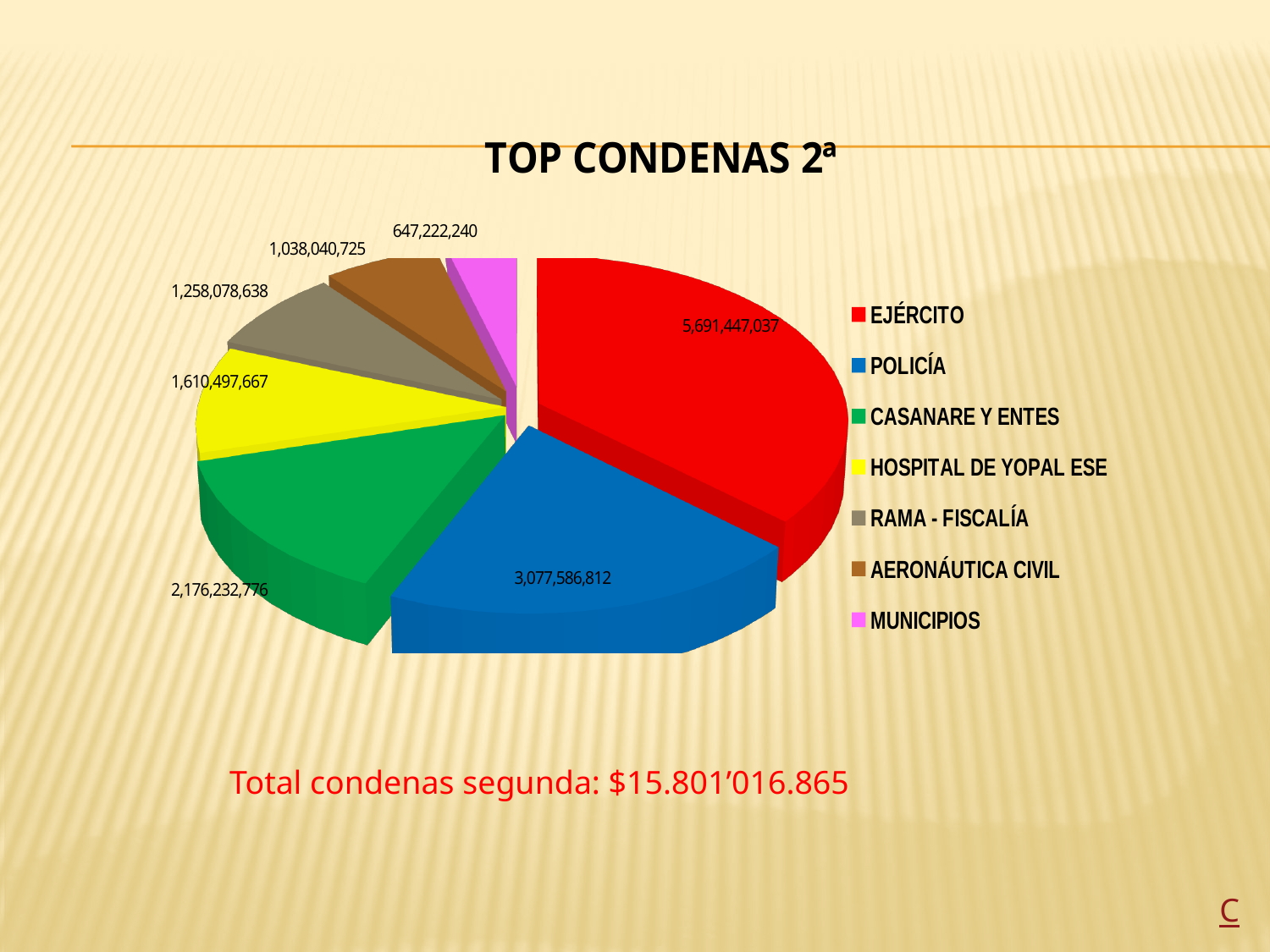
What is the value for POLICÍA? 3,077,586,812 What kind of chart is shown on the slide? Pie chart What is the value for HOSPITAL DE YOPAL ESE? 1,610,497,667 What is the value for EJÉRCITO? 5,691,447,037 Which category has the smallest slice? MUNICIPIOS What is the title of the chart? TOP CONDENAS 2ª What colour is the slice for AERONÁUTICA CIVIL? Brown What is the value for MUNICIPIOS? 647,222,240 What is the difference between the values for EJÉRCITO and POLICÍA? 2,613,860,225 Which category has the largest slice? EJÉRCITO Which is larger, the value for CASANARE Y ENTES or the value for RAMA - FISCALÍA? CASANARE Y ENTES How many categories does the legend list? 7